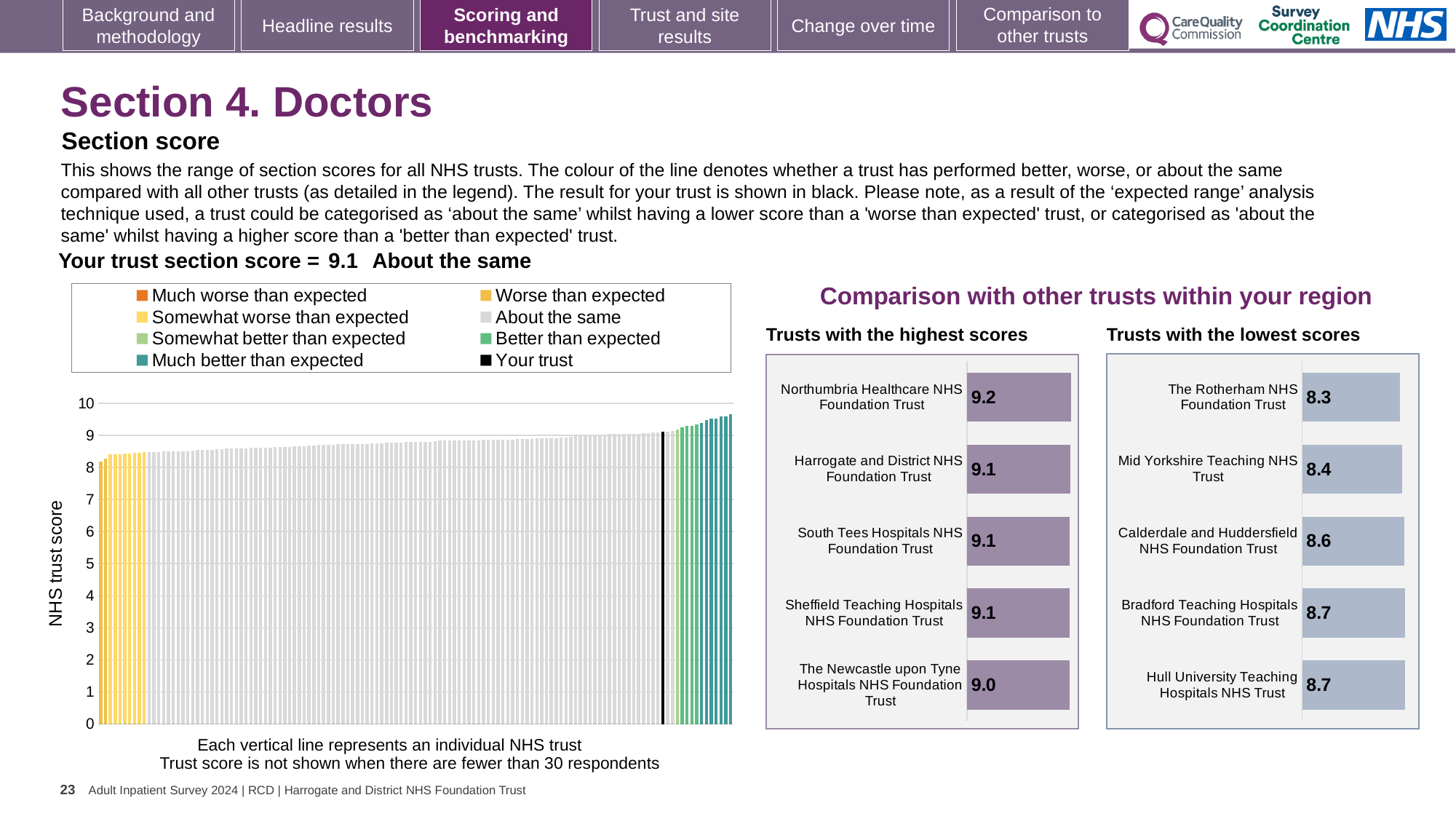
How many entries does the legend of the NHS trust score chart on the left list? 8 What is the difference between Northumbria Healthcare NHS Foundation Trust's score in the 'Trusts with the highest scores' chart and The Rotherham NHS Foundation Trust's score in the 'Trusts with the lowest scores' chart? 0.9 In the 'Trusts with the highest scores' chart, what is the score for The Newcastle upon Tyne Hospitals NHS Foundation Trust? 9.0 In the 'Trusts with the lowest scores' chart, what is the score for Calderdale and Huddersfield NHS Foundation Trust? 8.6 What kind of chart is the NHS trust score chart on the left of the slide? Bar chart In the 'Trusts with the highest scores' chart, which trust has the highest score? Northumbria Healthcare NHS Foundation Trust In the 'Trusts with the lowest scores' chart, which trust has the lowest score? The Rotherham NHS Foundation Trust In the 'Trusts with the lowest scores' chart, what is the score for The Rotherham NHS Foundation Trust? 8.3 How many trusts are shown in the 'Trusts with the highest scores' chart? 5 In the 'Trusts with the highest scores' chart, what is the score for Northumbria Healthcare NHS Foundation Trust? 9.2 In the NHS trust score chart on the left, do the bar heights rise or fall from left to right? Rise In the 'Trusts with the lowest scores' chart, which has the larger score: Mid Yorkshire Teaching NHS Trust or Bradford Teaching Hospitals NHS Foundation Trust? Bradford Teaching Hospitals NHS Foundation Trust